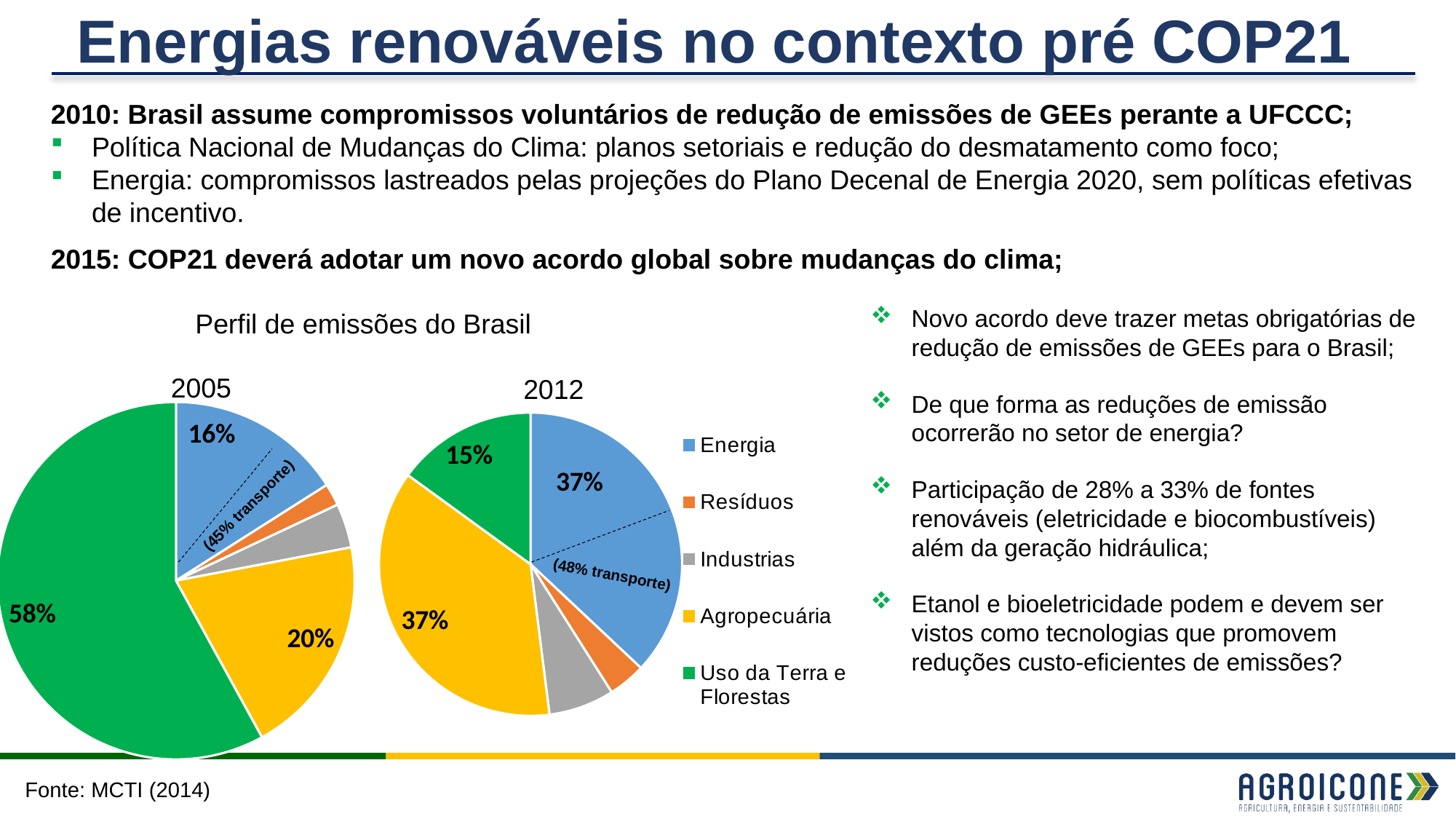
In the 2012 pie chart, which category has the smallest share? Resíduos In the 2005 pie chart, what share of emissions is Uso da Terra e Florestas? 58% In the 2005 pie chart, which category has the smallest share? Resíduos How many categories does the legend of the emissions pie charts list? 5 What kind of charts are shown under the title 'Perfil de emissões do Brasil'? Pie charts In the 2012 pie chart, what share of emissions is Agropecuária? 37% By how many percentage points did the Energia share increase from the 2005 pie chart to the 2012 pie chart? 21 percentage points In the 2012 pie chart, what share of emissions is Uso da Terra e Florestas? 15% In the 2005 pie chart, what share of emissions is Energia? 16% In the 2005 pie chart, what is the difference in percentage points between Uso da Terra e Florestas and Agropecuária? 38 percentage points In the 2005 pie chart, which category has the largest share? Uso da Terra e Florestas In the 2005 pie chart, which is larger: Agropecuária or Energia? Agropecuária